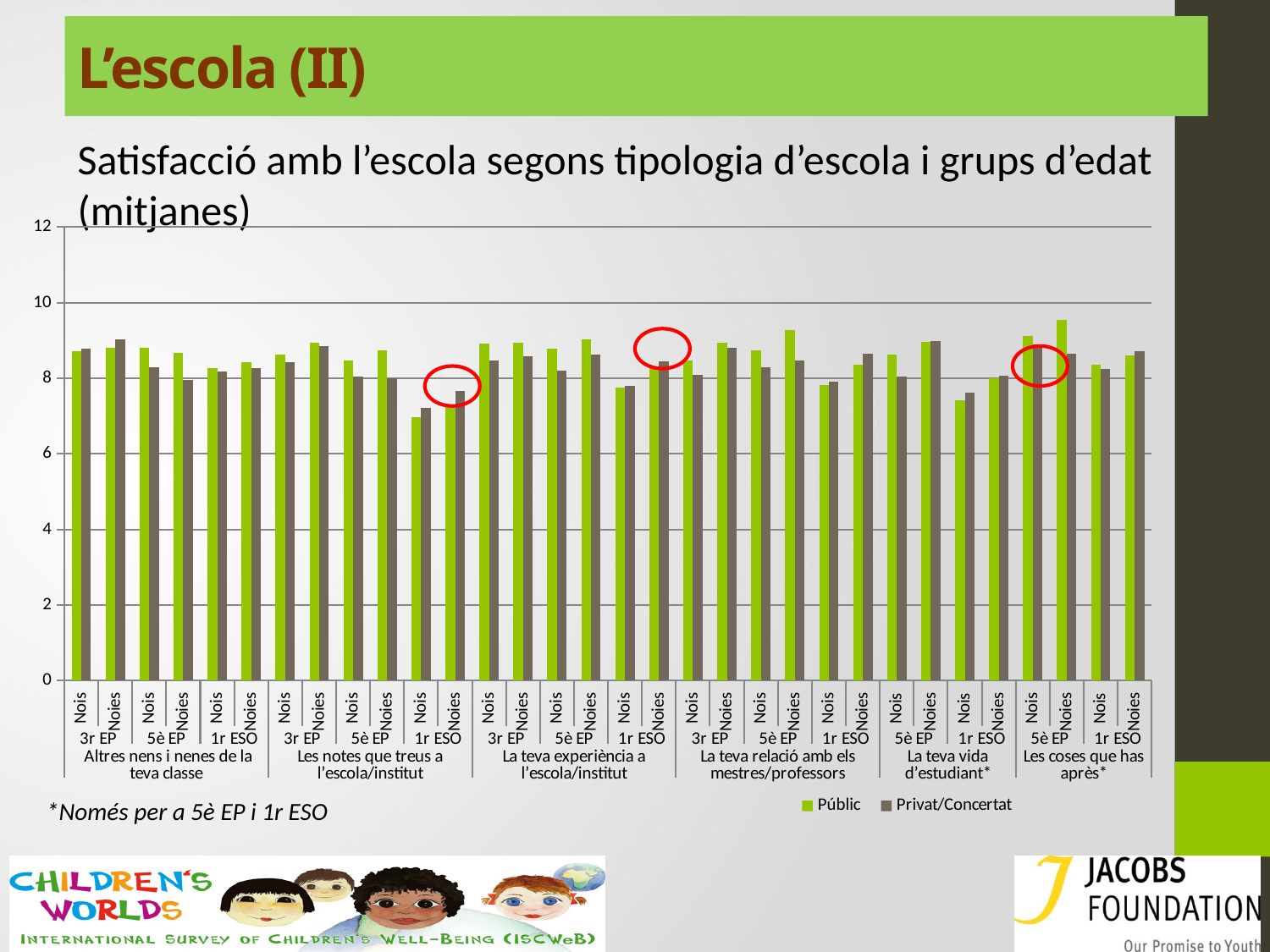
How many series does the chart legend list? 2 For Noies in 5è EP under 'Les coses que has après*', which is larger: Públic or Privat/Concertat? Públic Under 'Les notes que treus a l'escola/institut', do the Públic values for Nois rise or fall from 3r EP to 1r ESO? fall Is the Públic value for Nois in 1r ESO under 'Les notes que treus a l'escola/institut' greater or less than 8? less Is the Públic value for Noies in 5è EP under 'Les coses que has après*' greater or less than 9? greater For Noies in 5è EP under 'La teva relació amb els mestres/professors', which is larger: Públic or Privat/Concertat? Públic Is the Públic value for Nois in 1r ESO under 'La teva vida d'estudiant*' greater or less than 8? less Which bar is the lowest in the whole chart? Públic, Nois, 1r ESO, Les notes que treus a l'escola/institut How many question groups (e.g. 'Altres nens i nenes de la teva classe') are shown along the x axis? 6 What kind of chart is shown on the slide? Bar chart Which colour represents the Públic series in the chart? Green